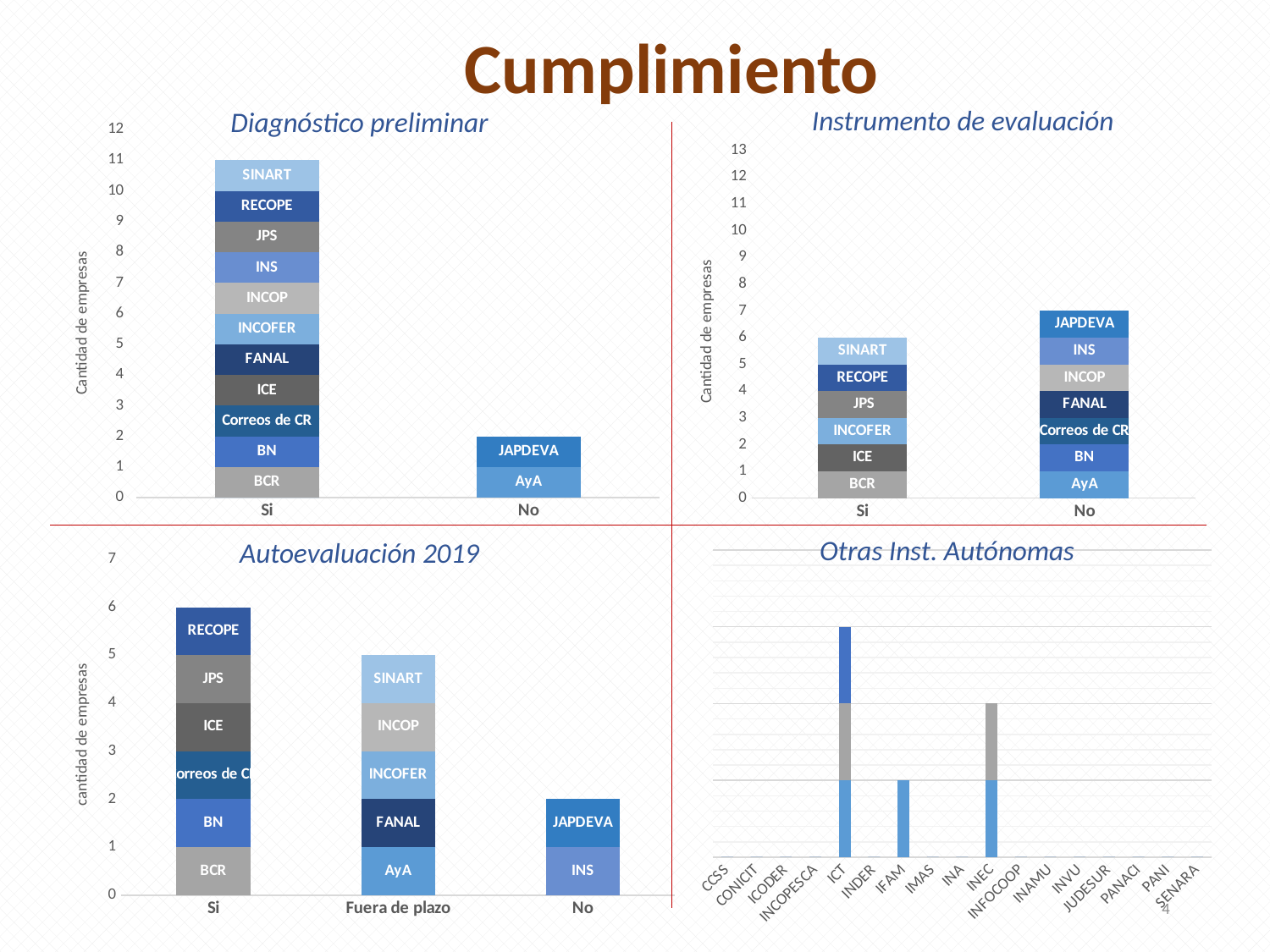
In the 'Instrumento de evaluación' chart, what is the total height of the 'No' stacked bar? 7 In the 'Diagnóstico preliminar' chart, which category has the taller bar, 'Si' or 'No'? Si In the 'Instrumento de evaluación' chart, what is the total height of the 'Si' stacked bar? 6 In the 'Otras Inst. Autónomas' chart, which category has the highest bar? ICT In the 'Diagnóstico preliminar' chart, what is the total height of the 'No' stacked bar? 2 In the 'Instrumento de evaluación' chart, which category has the taller bar, 'Si' or 'No'? No In the 'Diagnóstico preliminar' chart, which two institutions make up the 'No' bar? AyA and JAPDEVA In the 'Autoevaluación 2019' chart, which category has the lowest bar? No In the 'Autoevaluación 2019' chart, how many categories are shown on the x axis? 3 What kind of chart is the 'Diagnóstico preliminar' chart? Stacked bar chart